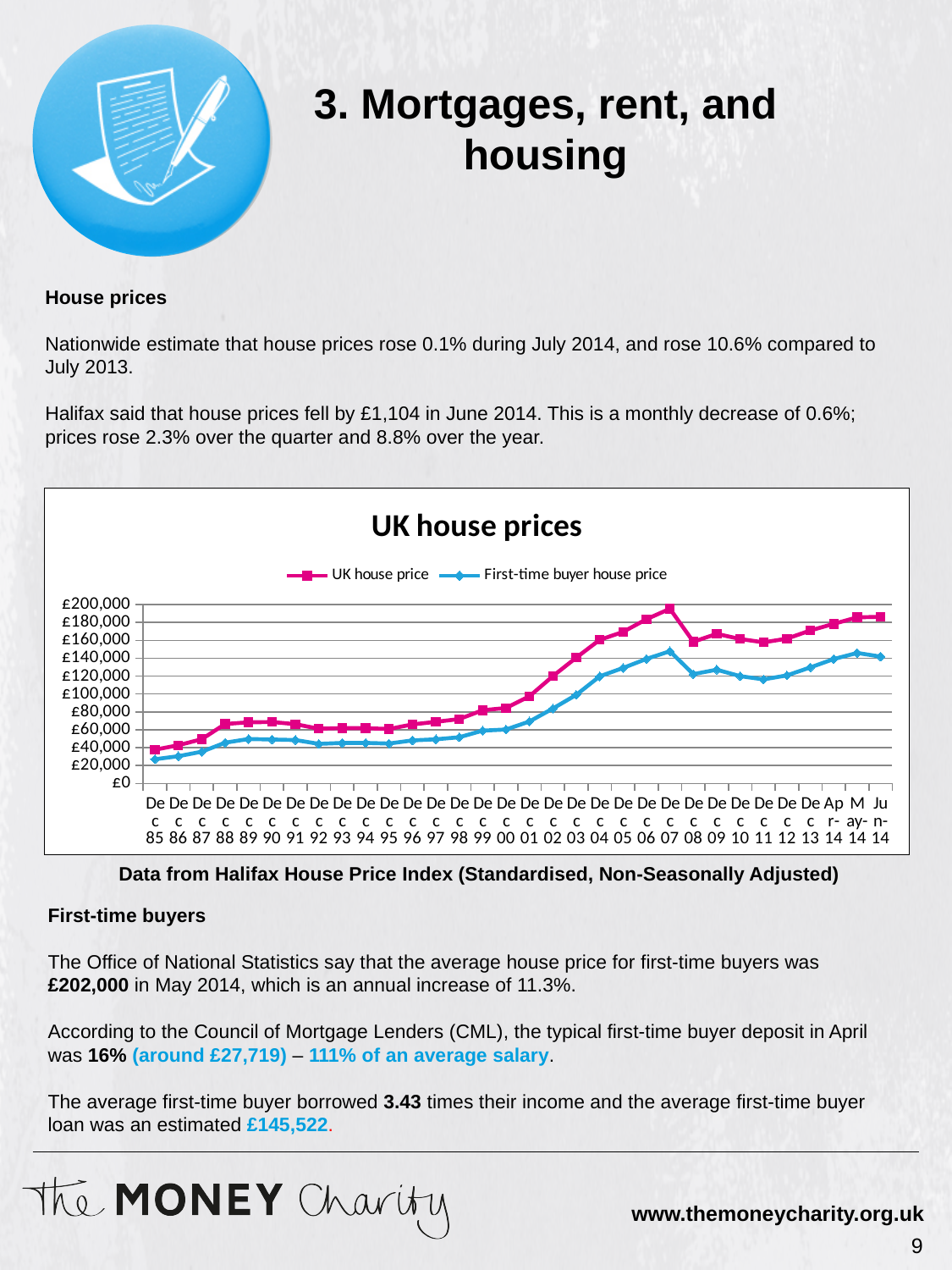
Is the First-time buyer house price for Jun 14 greater or less than £120,000? greater Overall, do UK house prices rise or fall from Dec 85 to Jun 14? rise Which series is drawn in blue in the chart? First-time buyer house price In Dec 07, which series has the higher value: UK house price or First-time buyer house price? UK house price Is the UK house price for Dec 07 greater or less than £180,000? greater Is the First-time buyer house price for Dec 85 greater or less than £40,000? less In which period does the UK house price series reach its highest point? Dec 07 How many series does the chart's legend list? 2 What kind of chart is shown on the slide? line chart What is the title of the chart? UK house prices